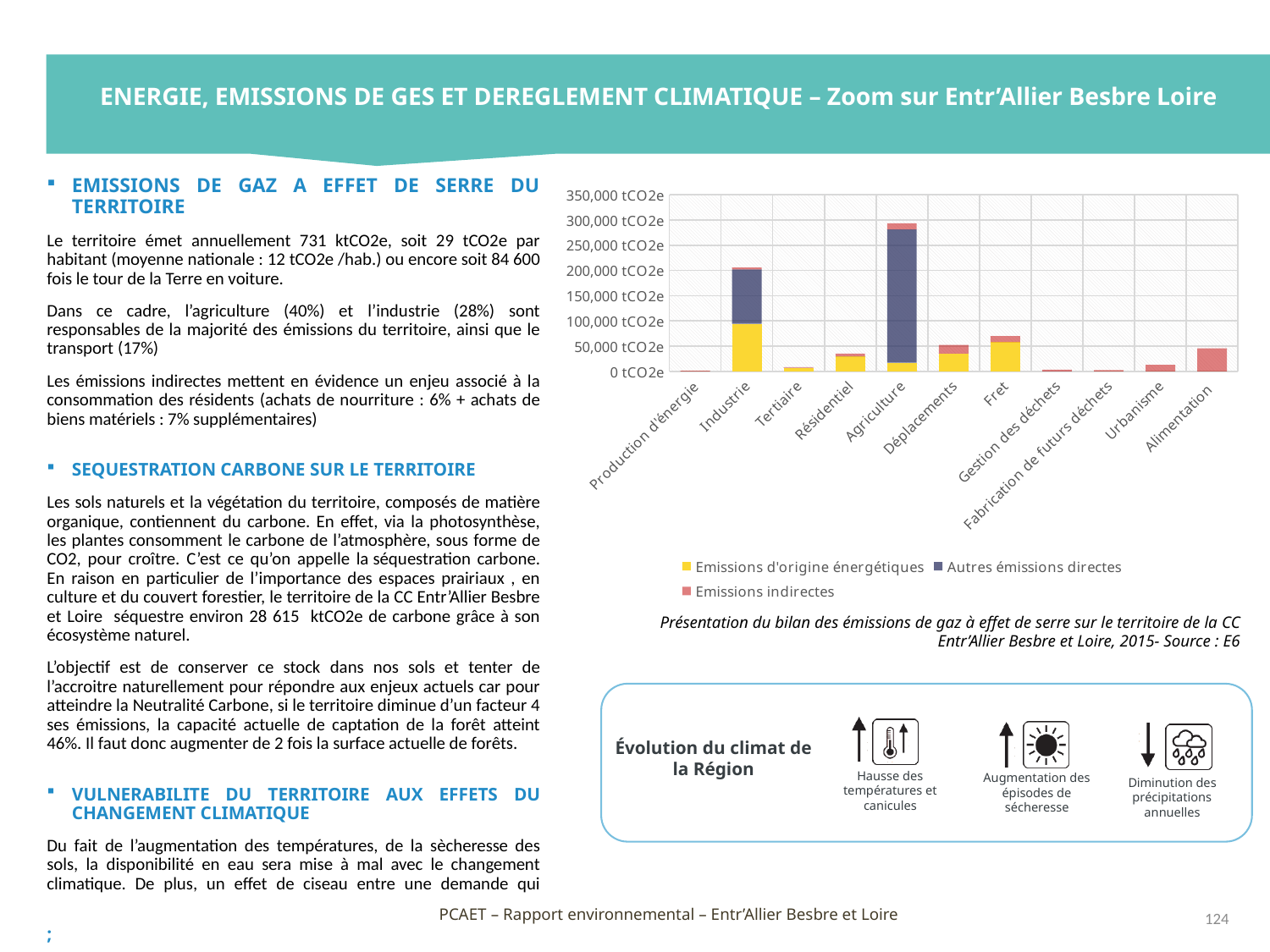
Which category has the highest total emissions in the chart? Agriculture Is the total value for Industrie greater or less than 150,000 tCO2e? greater Is the total value for Tertiaire greater or less than 50,000 tCO2e? less Which has a larger total, Agriculture or Industrie? Agriculture Is the total value for Fret greater or less than 50,000 tCO2e? greater How many series does the chart's legend list? 3 What kind of chart is shown on the slide? Stacked bar chart Which series in the legend is shown in yellow? Emissions d'origine énergétiques How many categories are shown on the x axis of the chart? 11 Which has a larger total, Industrie or Fret? Industrie